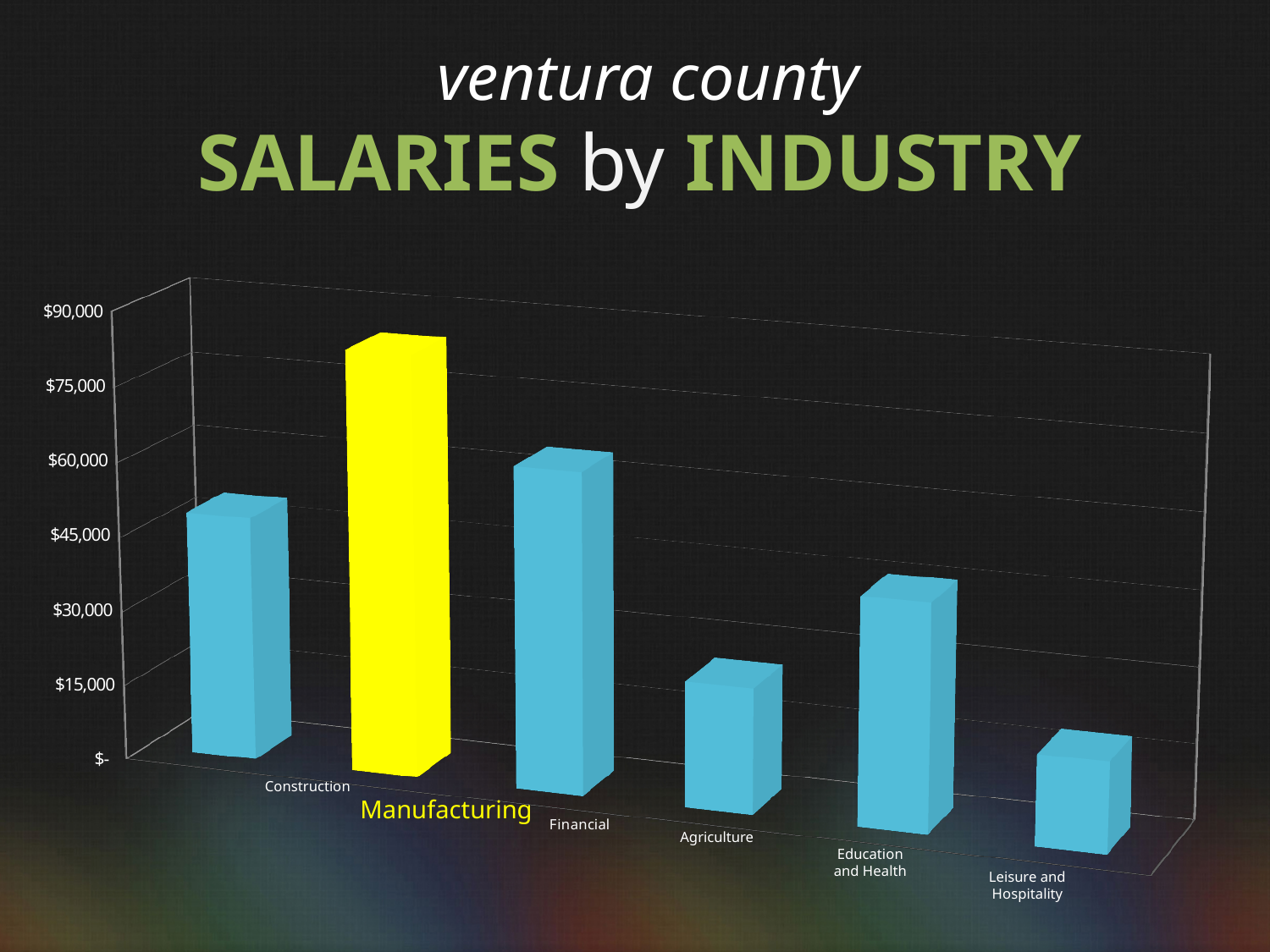
Is the value for Construction greater or less than $30,000? greater Which is larger, the salary for Construction or for Education and Health? Construction What kind of chart is shown on the slide? bar chart Is the value for Agriculture greater or less than $30,000? less Is the value for Financial greater or less than $75,000? less Which industry's bar is highlighted in yellow? Manufacturing Which industry has the highest salary in the chart? Manufacturing Which is larger, the salary for Financial or for Construction? Financial How many industries are plotted in the chart? 6 Which industry has the lowest salary in the chart? Leisure and Hospitality